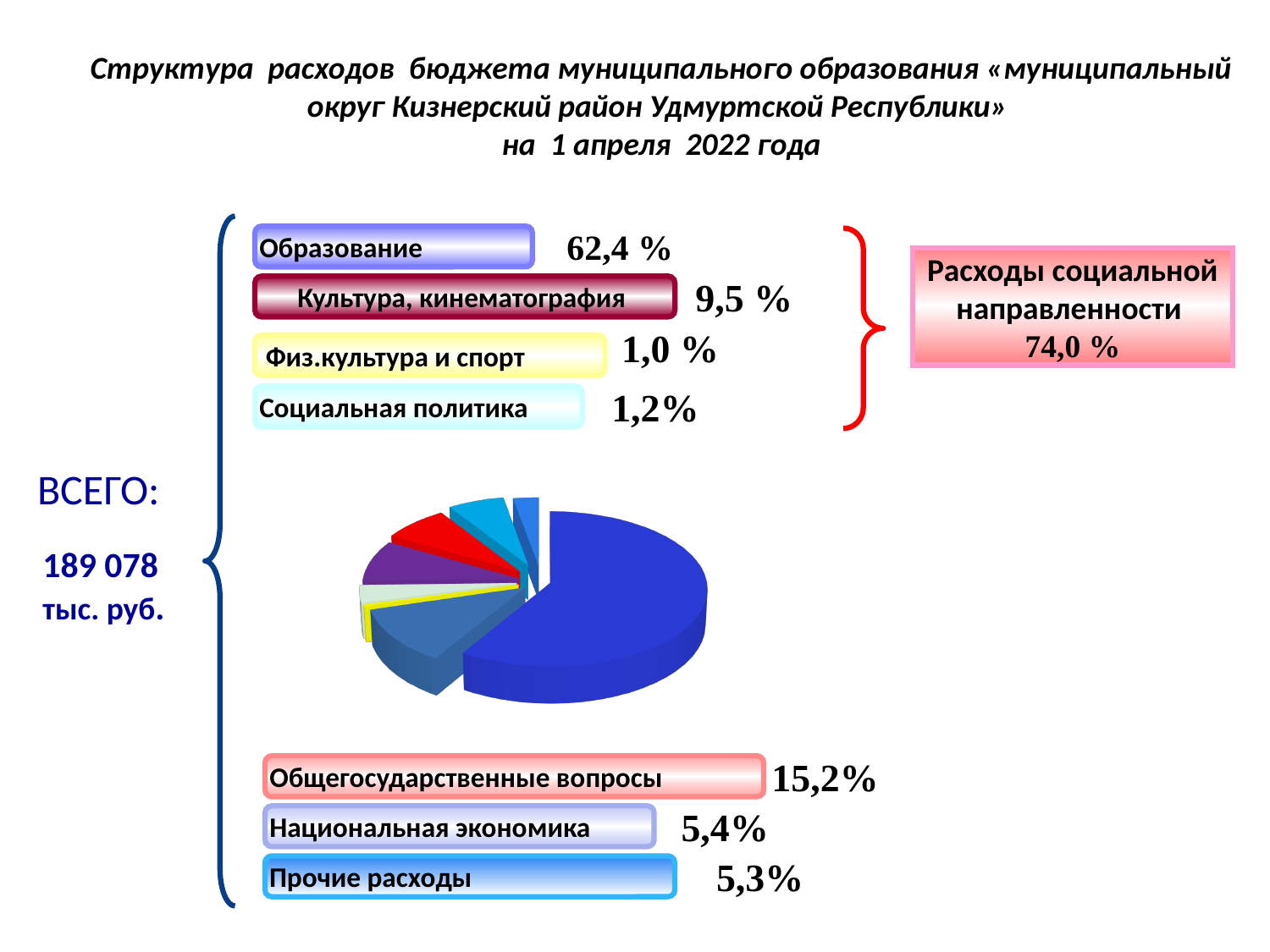
Which expenditure category has the largest share? Образование How many expenditure categories are listed on the slide? 7 What kind of chart is shown on the slide? pie chart What share of budget expenditures is shown for Культура, кинематография? 9,5 % What share of budget expenditures is shown for Общегосударственные вопросы? 15,2% Which has a larger share, Национальная экономика or Прочие расходы? Национальная экономика What combined share is given for Расходы социальной направленности? 74,0 % What is the total budget expenditure (ВСЕГО) shown on the slide? 189 078 тыс. руб. What is the difference in percentage points between Образование and Культура, кинематография? 52,9 What share of budget expenditures is shown for Образование? 62,4 % Which expenditure category has the smallest share? Физ.культура и спорт What share of budget expenditures is shown for Социальная политика? 1,2%